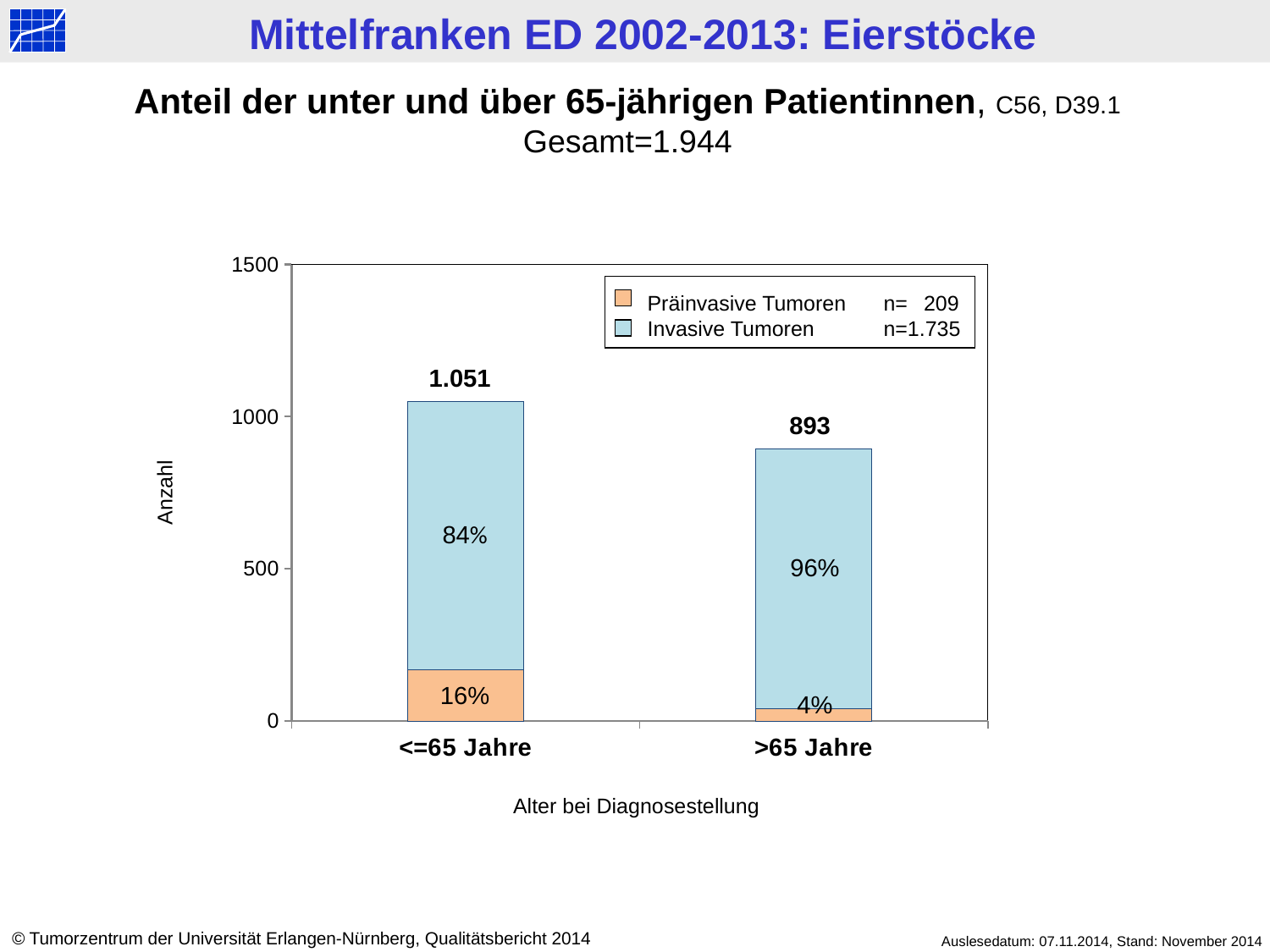
What percentage of the >65 Jahre bar is Präinvasive Tumoren? 4% What percentage of the <=65 Jahre bar is Invasive Tumoren? 84% How many age categories are shown on the x axis? 2 What kind of chart is shown on the slide? Stacked bar chart What is the difference between the totals of the <=65 Jahre and >65 Jahre bars? 158 What is the total number of patients shown for the <=65 Jahre bar? 1.051 According to the legend, what is the n for Invasive Tumoren? n=1.735 Which age group has the higher total number of patients? <=65 Jahre What is the total number of patients shown for the >65 Jahre bar? 893 Is the total for the >65 Jahre bar greater or less than 1000? less How many series does the legend list? 2 What percentage of the >65 Jahre bar is Invasive Tumoren? 96%